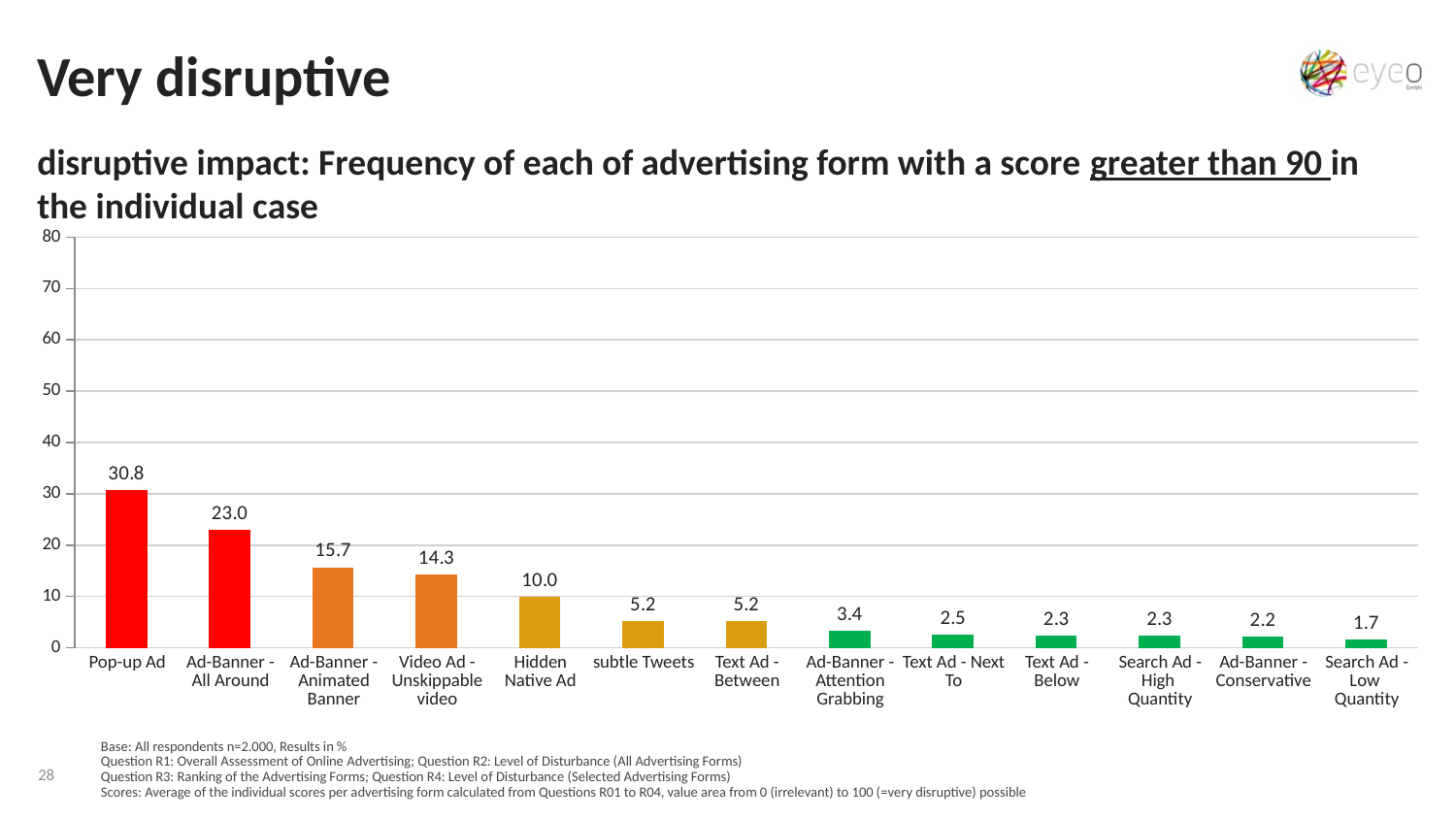
What is the difference between the values for Pop-up Ad and Ad-Banner - All Around? 7.8 Which is larger, the value for Ad-Banner - Animated Banner or Video Ad - Unskippable video? Ad-Banner - Animated Banner What is the value for Search Ad - Low Quantity? 1.7 Which advertising form has the highest value? Pop-up Ad How many advertising forms are shown on the x axis? 13 Is the value for Ad-Banner - All Around greater or less than 20? greater What colour are the bars for Pop-up Ad and Ad-Banner - All Around? red What kind of chart is shown on the slide? bar chart What is the value for Hidden Native Ad? 10.0 What is the value for Pop-up Ad? 30.8 Which advertising form has the lowest value? Search Ad - Low Quantity Do the values rise or fall from left to right along the x axis? fall